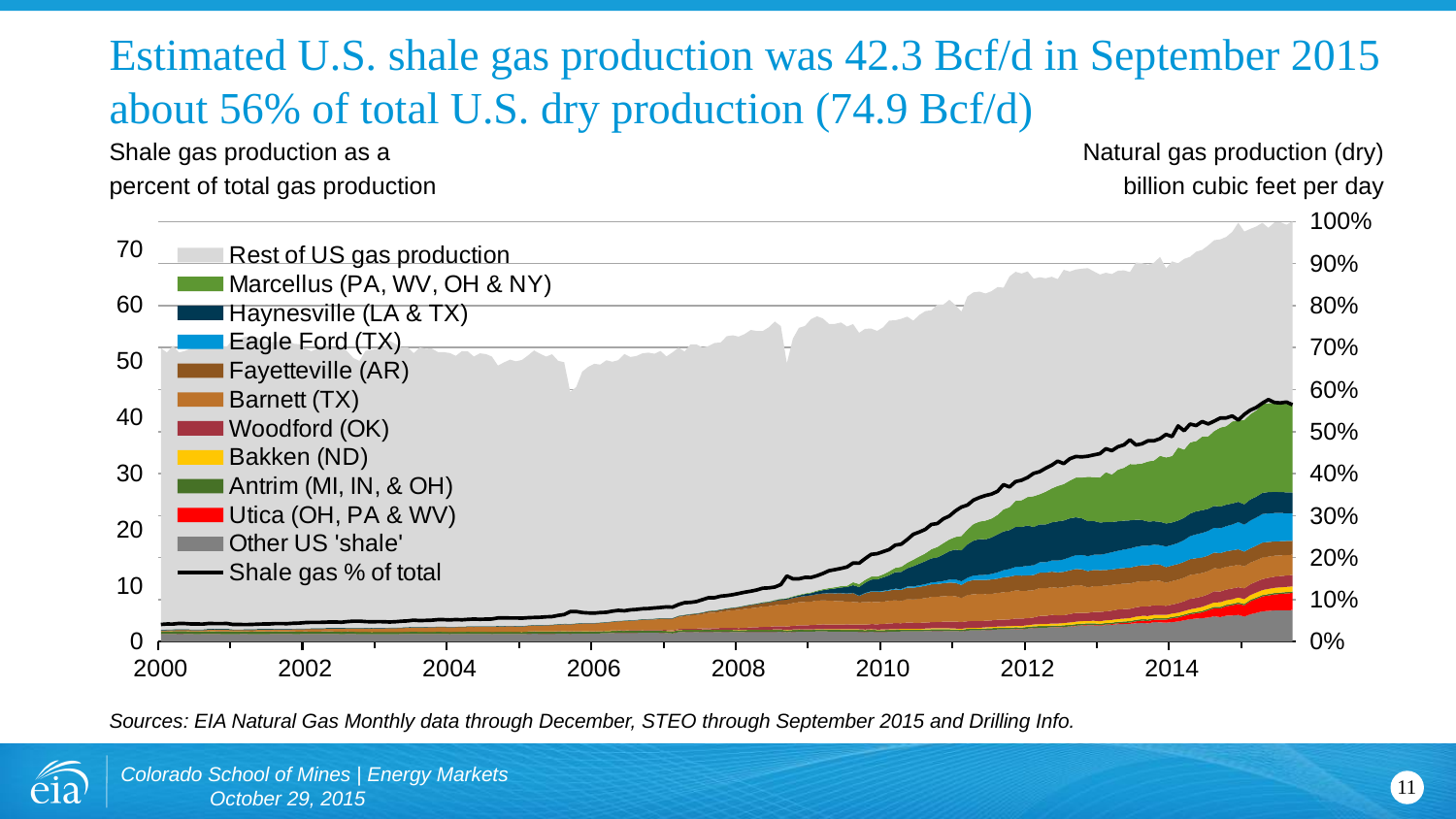
Which series is shown in light gray at the top of the stacked area? Rest of US gas production Is total natural gas production at the end of the series (2015) greater or less than 70 billion cubic feet per day? greater Is the 'Shale gas % of total' value in 2000 greater or less than 10%? less Does the 'Shale gas % of total' line rise or fall from 2000 to 2015? Rise How many entries does the chart legend list? 12 According to the slide, what was estimated U.S. shale gas production in September 2015? 42.3 Bcf/d What kind of chart is shown on the slide? Stacked area chart with a line Is the 'Shale gas % of total' value at the end of the series (2015) greater or less than 50%? greater What is the unit shown on the right-hand axis of the chart? Percent (%) According to the slide, shale gas was about what percent of total U.S. dry production in September 2015? 56% How many year labels are shown on the x axis? 8 According to the slide, what was total U.S. dry natural gas production in September 2015? 74.9 Bcf/d